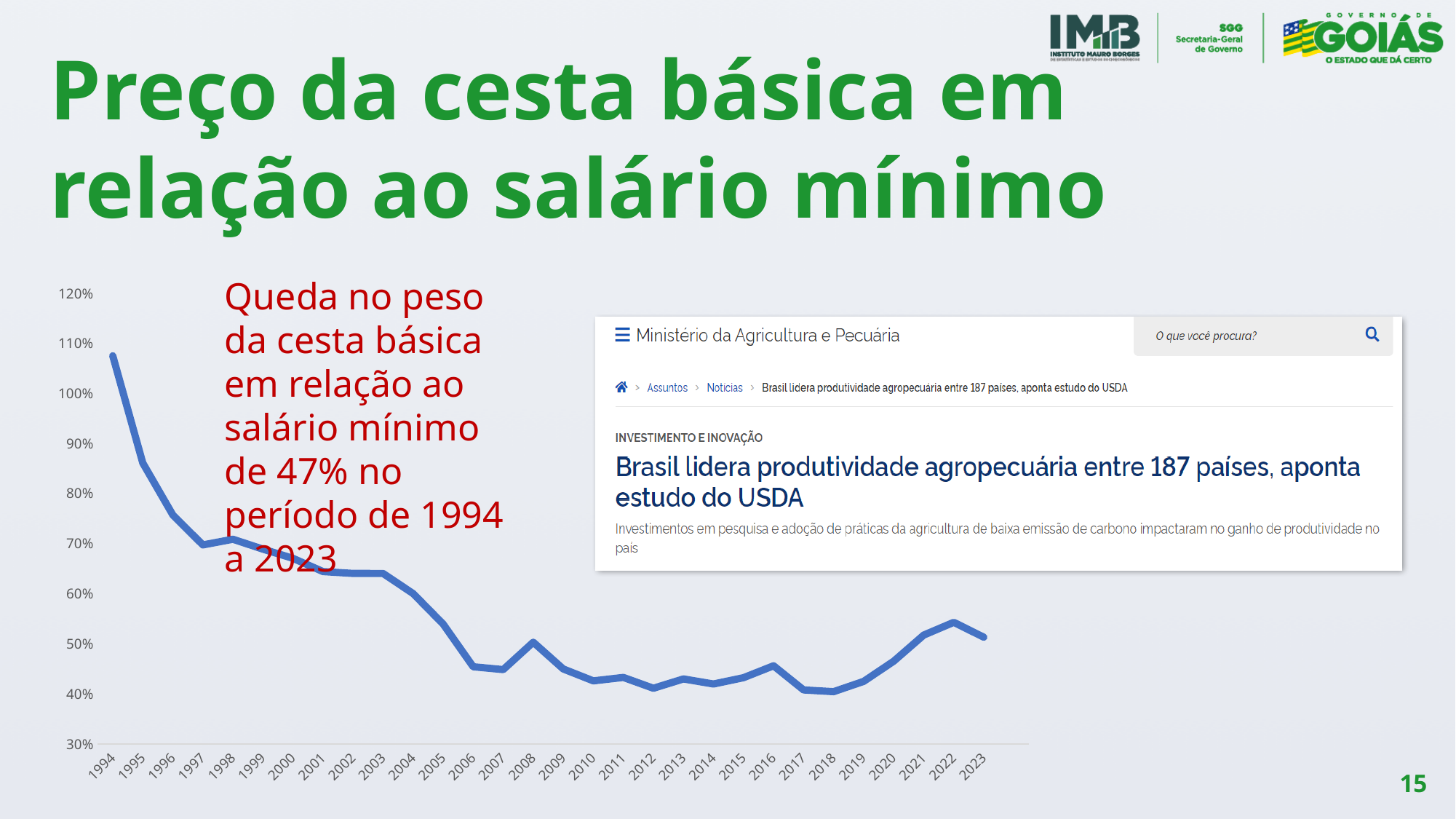
How many years are plotted along the x axis of the chart? 30 Is the value for 2003 greater or less than 60%? greater Is the value for 2018 greater or less than 50%? less Is the value for 2005 greater or less than 60%? less What is the lowest value shown on the y axis of the chart? 30% Which is larger, the value for 1994 or the value for 2023? 1994 Which year has the highest value on the chart? 1994 Overall, do the values rise or fall from 1994 to 2023? fall What kind of chart is shown on the slide? line chart Which is larger, the value for 2008 or the value for 2007? 2008 According to the red text on the slide, by what percentage did the weight of the basic food basket relative to the minimum wage fall between 1994 and 2023? 47%